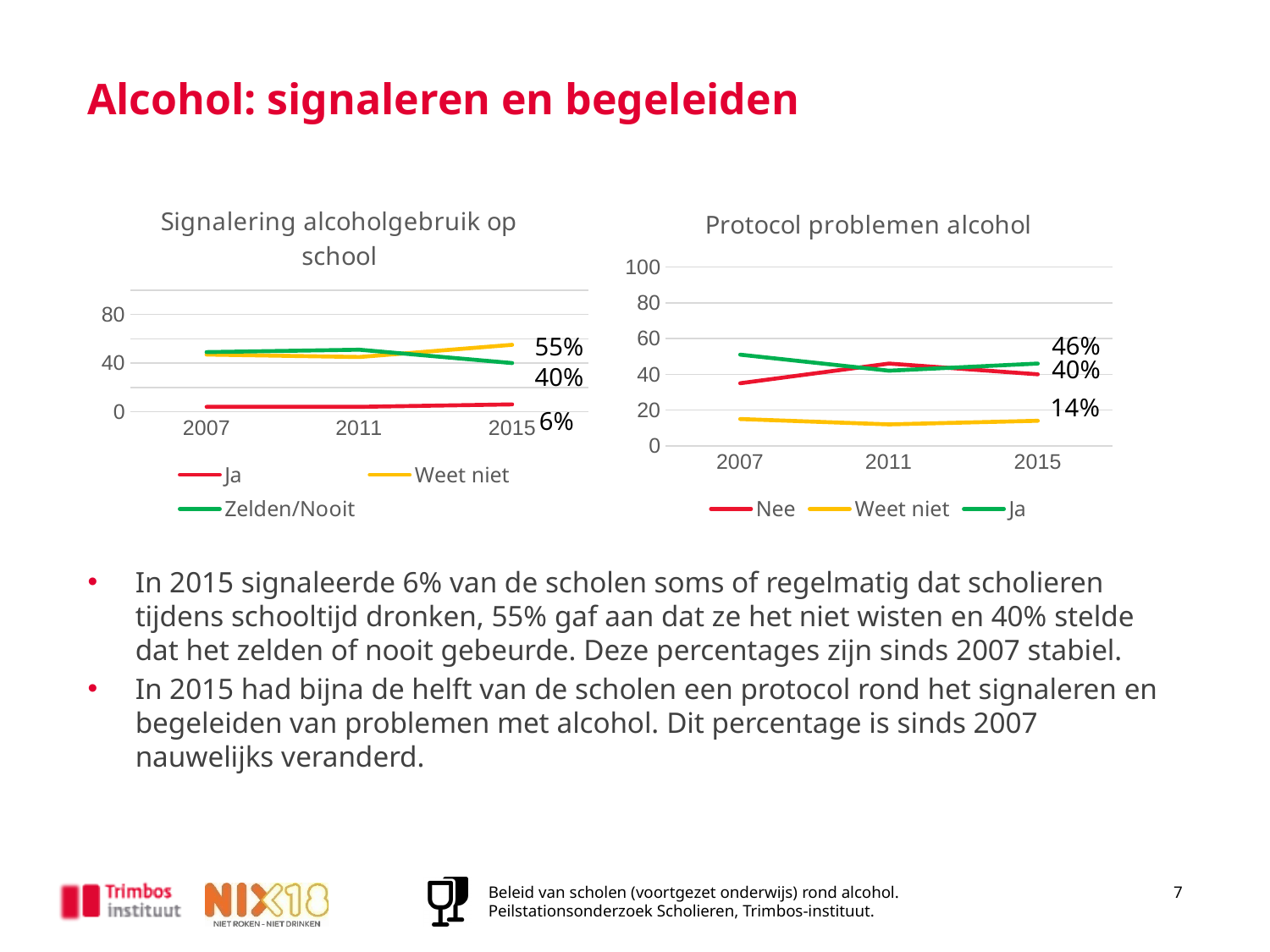
In the chart 'Signalering alcoholgebruik op school', is the value for 'Zelden/Nooit' in 2011 greater or less than 40? greater How many years are shown on the x axis of the chart 'Signalering alcoholgebruik op school'? 3 In the chart 'Protocol problemen alcohol', is the value for 'Nee' in 2007 greater or less than 40? less In the chart 'Protocol problemen alcohol', what is the value for 'Ja' in 2015? 46% In the chart 'Signalering alcoholgebruik op school', what is the value for 'Ja' in 2015? 6% In the chart 'Signalering alcoholgebruik op school', what is the difference between 'Weet niet' and 'Zelden/Nooit' in 2015? 15% In the chart 'Protocol problemen alcohol', which series has the lowest value in 2015? Weet niet What kind of chart is 'Protocol problemen alcohol'? Line chart In the chart 'Protocol problemen alcohol', which colour is used for the 'Weet niet' line? Yellow In the chart 'Signalering alcoholgebruik op school', what is the value for 'Weet niet' in 2015? 55% In the chart 'Protocol problemen alcohol', what is the value for 'Weet niet' in 2015? 14% How many series does the legend of the chart 'Protocol problemen alcohol' list? 3